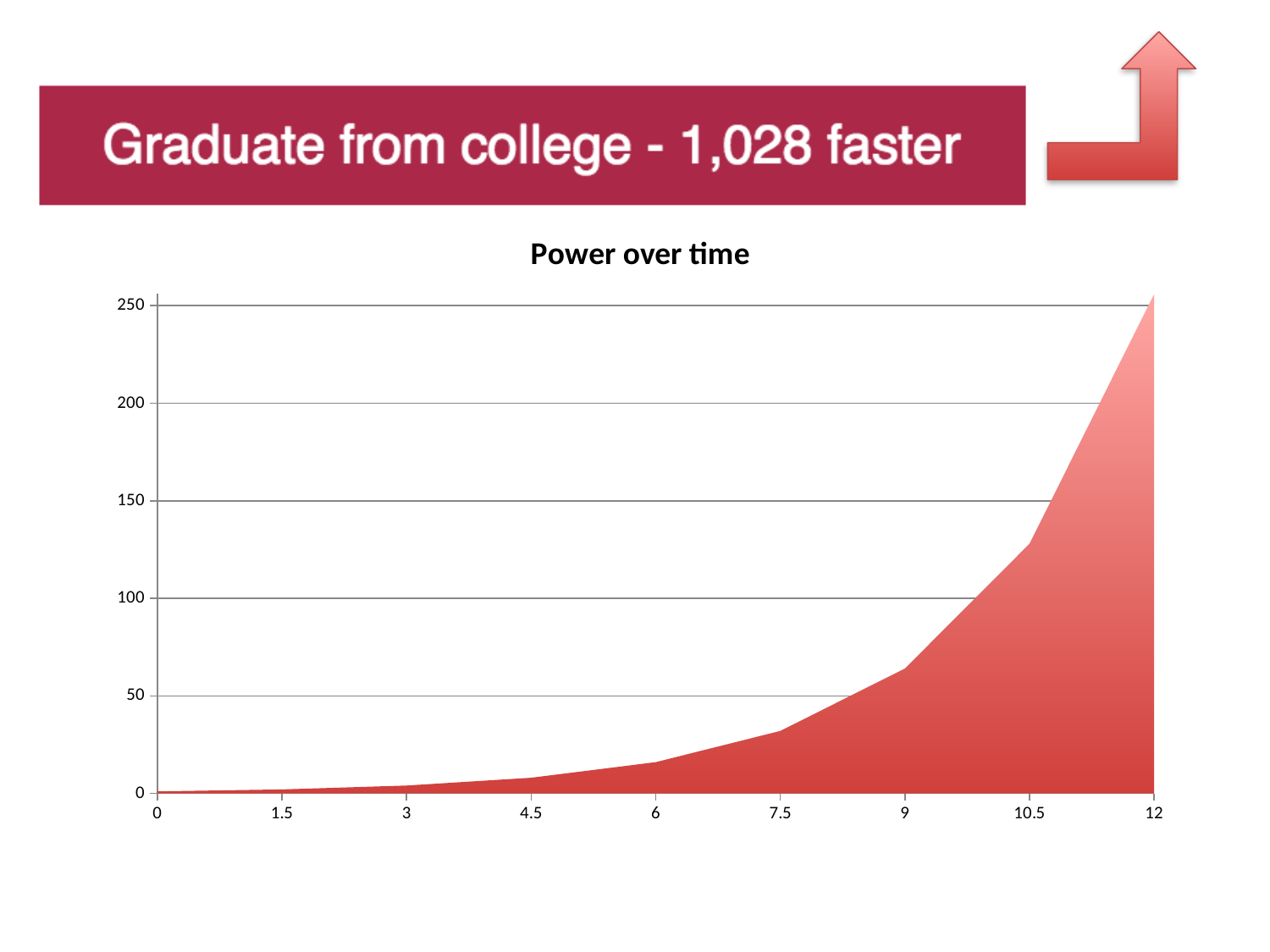
Which is larger, the value at x = 9 or the value at x = 6? x = 9 At which x-axis value is the plotted value highest? 12 Is the value at x = 7.5 greater or less than 50? less Is the value at x = 9 greater or less than 50? greater What is the title of the chart? Power over time Is the value at x = 10.5 greater or less than 150? less How many tick labels are shown on the x axis? 9 Do the values rise or fall as you move along the x axis from 0 to 12? rise What kind of chart is shown on the slide? area chart At which x-axis value is the plotted value lowest? 0